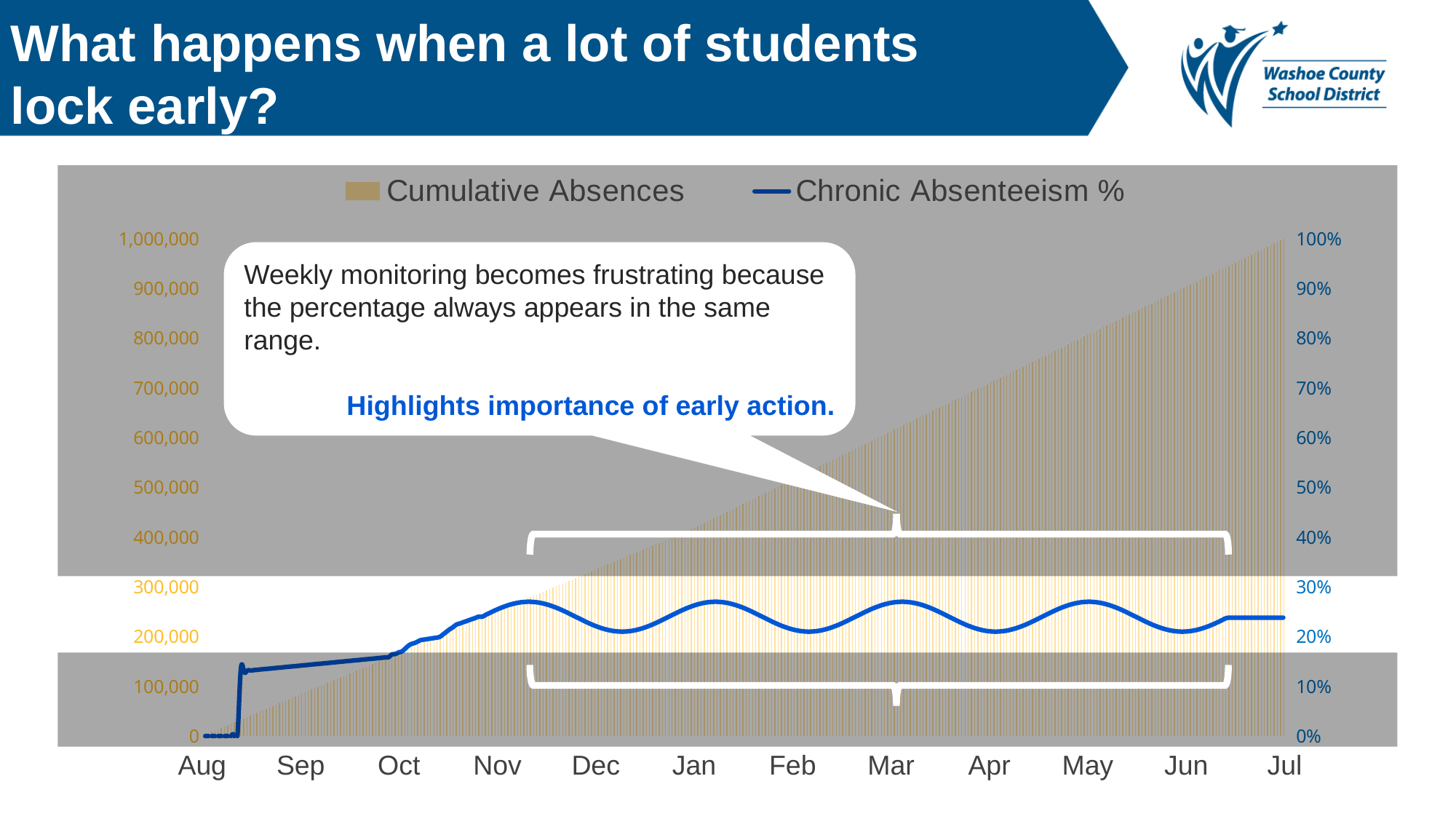
What kind of chart is shown on the slide? Combination bar and line chart How many series does the chart legend list? 2 Is the Chronic Absenteeism % value at the start of Aug greater or less than 10%? less Do the Cumulative Absences values rise or fall from Aug to Jul? Rise How many months are labelled along the x axis of the chart? 12 Is the Chronic Absenteeism % value at Jan greater or less than 20%? greater Is the Cumulative Absences value at Dec greater or less than 500,000? less What is the highest tick shown on the right-hand axis of the chart? 100% Which series is plotted as a line in the chart? Chronic Absenteeism %